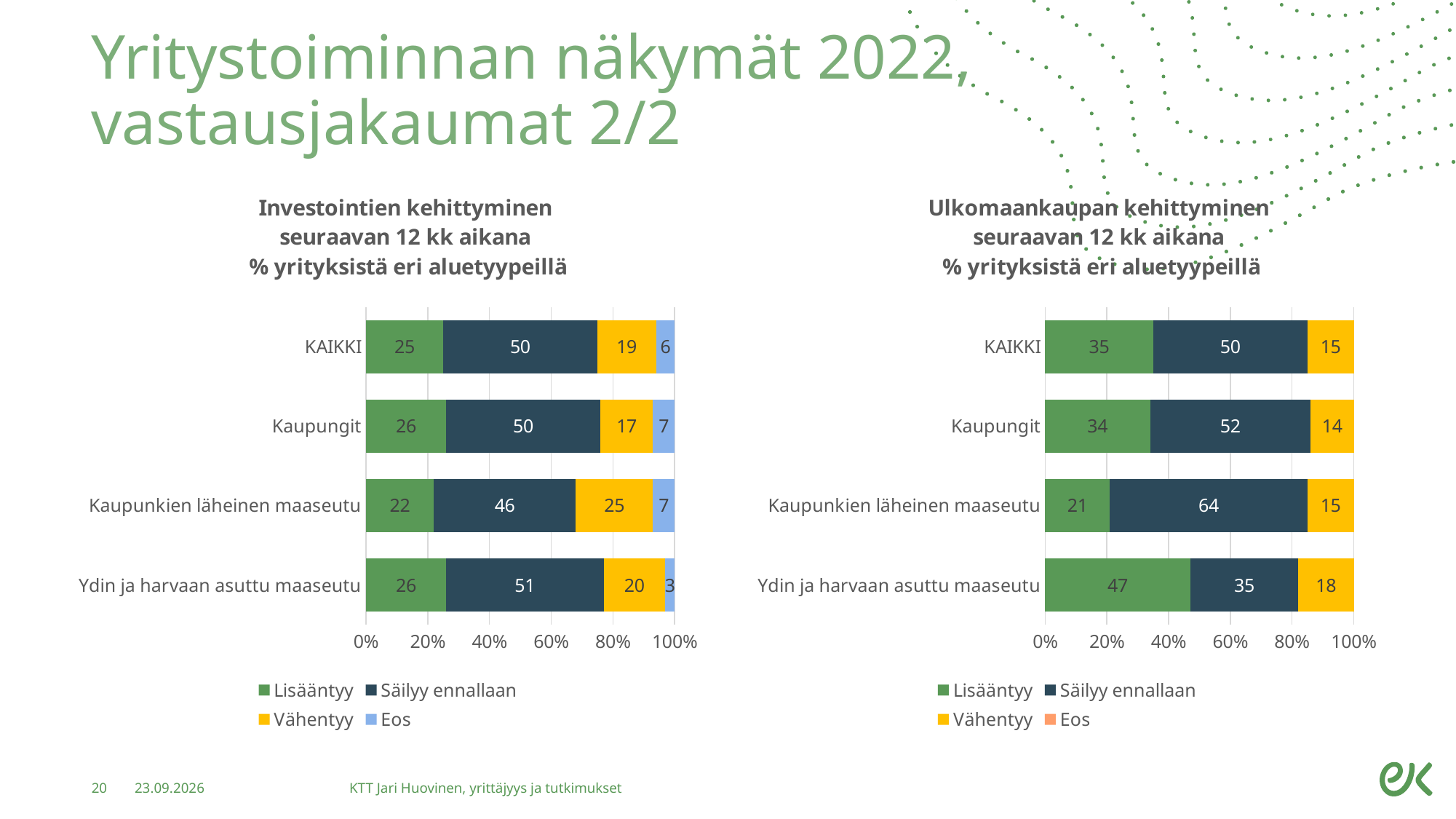
How many series does the legend of the 'Investointien kehittyminen' chart list? 4 In the 'Ulkomaankaupan kehittyminen' chart, what colour represents the Vähentyy series? Yellow In the 'Ulkomaankaupan kehittyminen' chart, which category has the highest Säilyy ennallaan value? Kaupunkien läheinen maaseutu How many categories are shown on the y axis of the 'Ulkomaankaupan kehittyminen' chart? 4 In the 'Ulkomaankaupan kehittyminen' chart, what is the difference between the Lisääntyy values for Ydin ja harvaan asuttu maaseutu and Kaupunkien läheinen maaseutu? 26 In the 'Ulkomaankaupan kehittyminen' chart, what is the Lisääntyy value for Ydin ja harvaan asuttu maaseutu? 47 What kind of chart is the 'Ulkomaankaupan kehittyminen' chart? Stacked bar chart In the 'Investointien kehittyminen' chart, what is the total of the Lisääntyy and Säilyy ennallaan values for KAIKKI? 75 In the 'Investointien kehittyminen' chart, what is the Eos value for Ydin ja harvaan asuttu maaseutu? 3 In the 'Investointien kehittyminen' chart, which category has the lowest Lisääntyy value? Kaupunkien läheinen maaseutu In the 'Investointien kehittyminen' chart, what is the Säilyy ennallaan value for Kaupunkien läheinen maaseutu? 46 In the 'Investointien kehittyminen' chart, is the Vähentyy value larger for Kaupunkien läheinen maaseutu or for Kaupungit? Kaupunkien läheinen maaseutu